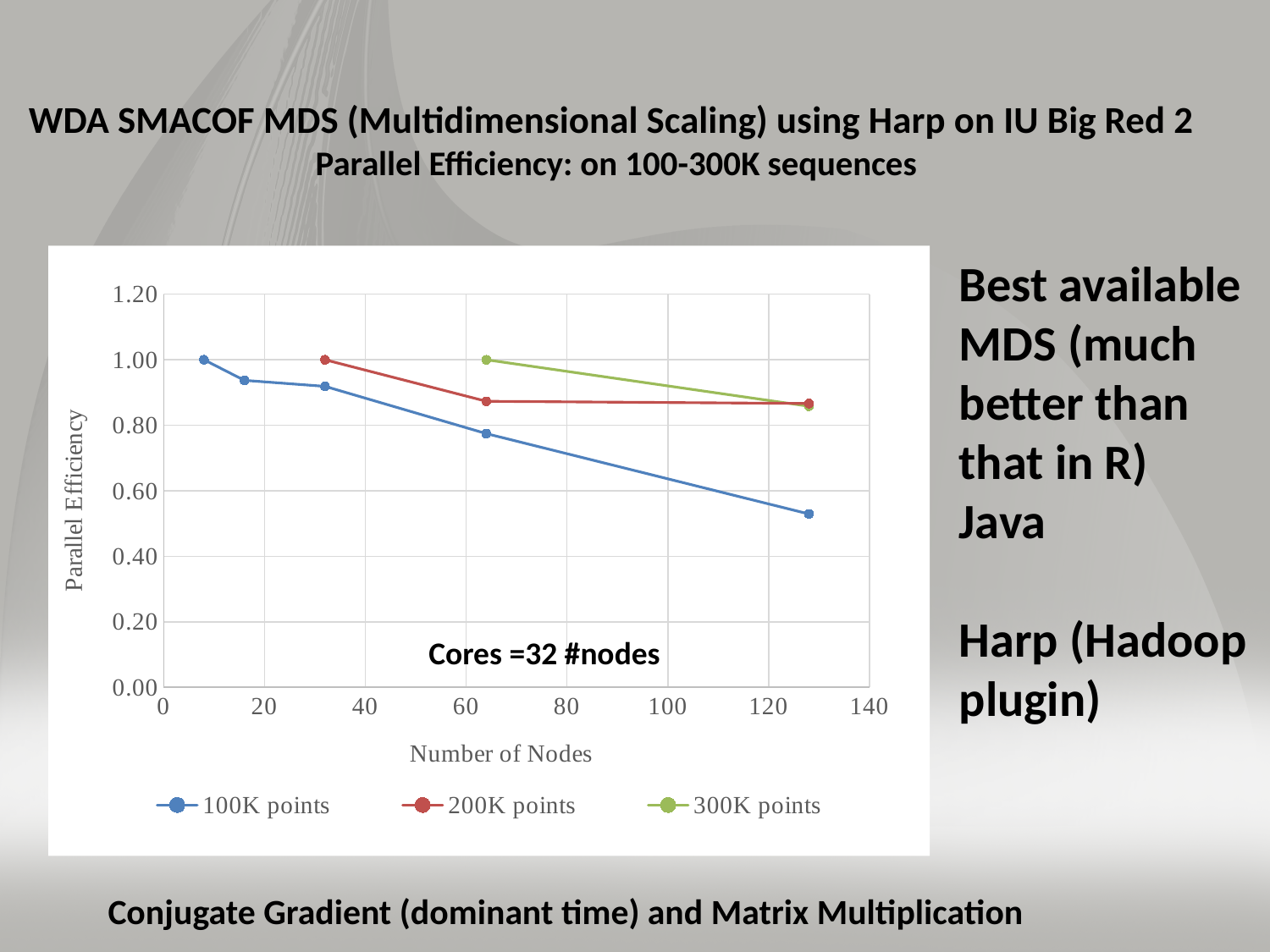
Which series has the lowest parallel efficiency at the largest number of nodes plotted? 100K points How many data points are plotted for the 100K points series? 5 How many data points are plotted for the 200K points series? 3 What is the title of the x axis? Number of Nodes How many data points are plotted for the 300K points series? 2 Is the parallel efficiency of the 100K points series at its last point (around 128 nodes) greater or less than 0.60? less At the largest number of nodes plotted, which series has the higher parallel efficiency, 100K points or 200K points? 200K points Is the parallel efficiency of the 200K points series at its last point (around 128 nodes) greater or less than 0.80? greater What kind of chart is shown on the slide? line chart What is the parallel efficiency of the first plotted point of the 200K points series? 1.00 How many series does the legend list? 3 Does the parallel efficiency of the 100K points series rise or fall as the number of nodes increases? falls